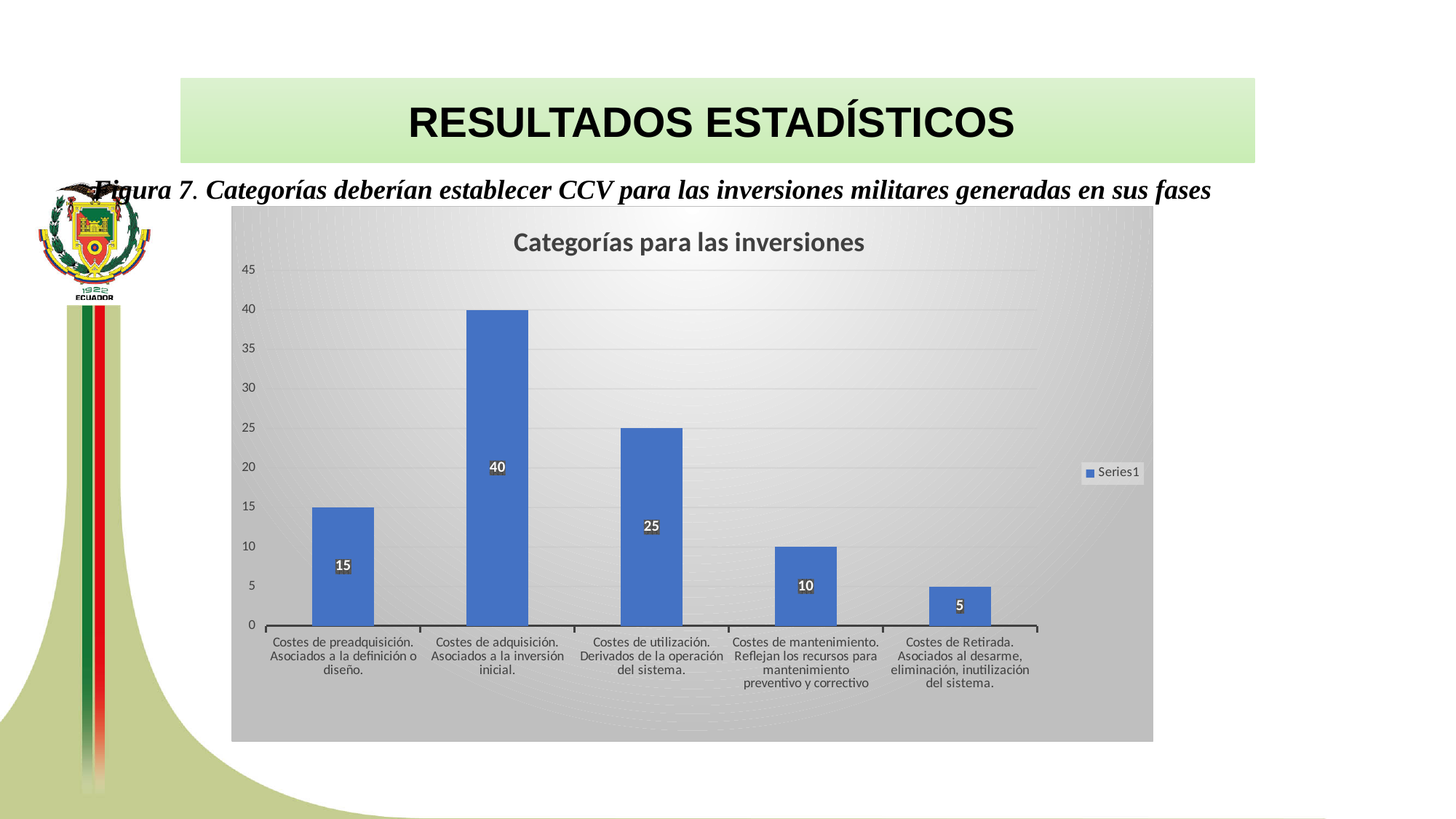
Which category has the lowest value? Costes de Retirada What is the difference between the values for Costes de adquisición and Costes de utilización? 15 What is the title of the chart? Categorías para las inversiones What is the value for Costes de adquisición? 40 Which category has the highest value? Costes de adquisición What kind of chart is shown? Bar chart Which is larger, the value for Costes de preadquisición or the value for Costes de mantenimiento? Costes de preadquisición What is the name of the series listed in the legend? Series1 What is the value for Costes de mantenimiento? 10 How many categories are shown in the chart? 5 How many series does the legend list? 1 What is the value for Costes de Retirada? 5